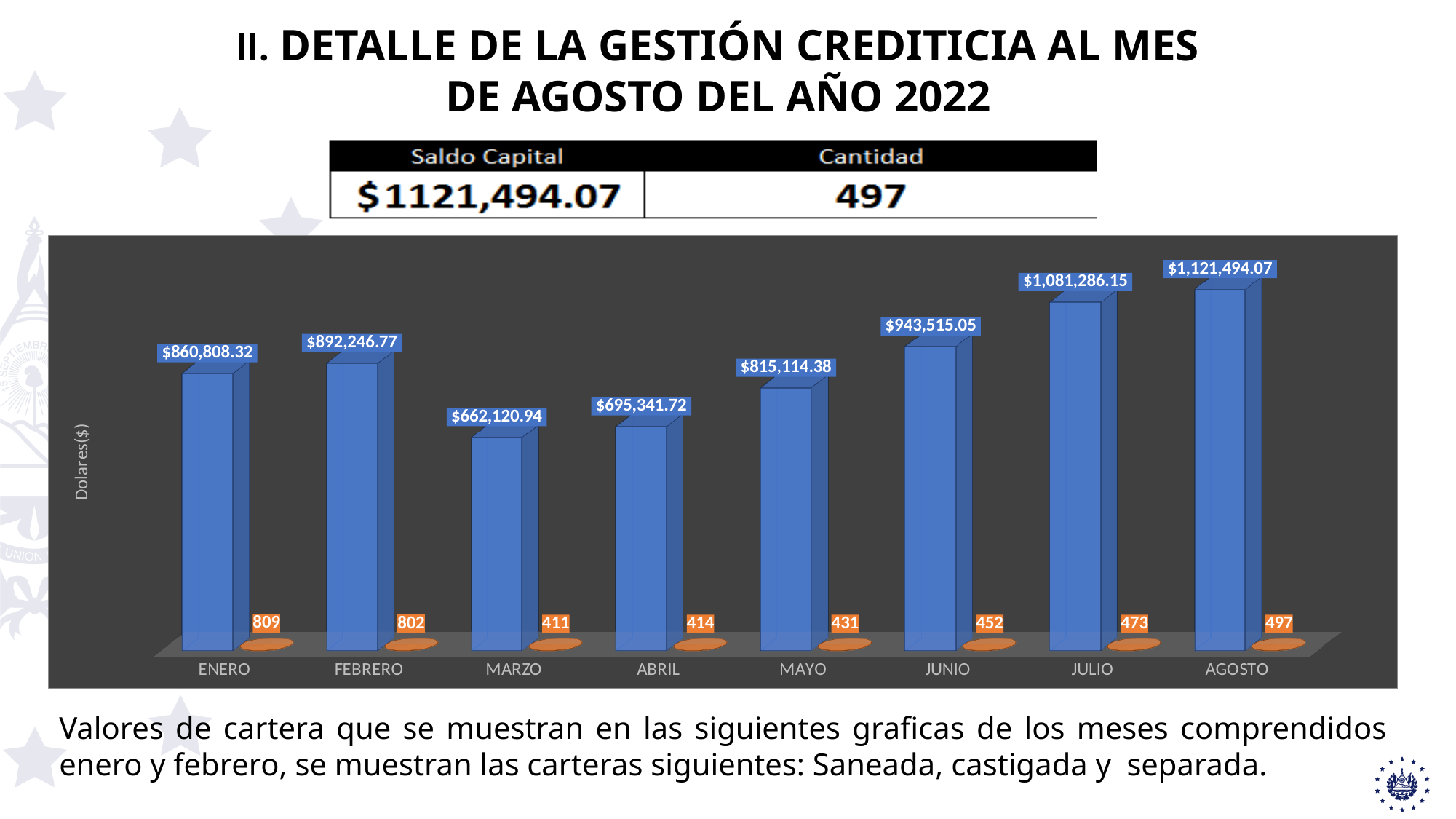
What is the dollar value shown for ENERO? $860,808.32 Do the dollar values rise or fall from MARZO to AGOSTO? rise What is the dollar value shown for JULIO? $1,081,286.15 What is the count (orange label) shown for JUNIO? 452 Which month has the lowest dollar value? MARZO Which has a larger dollar value, FEBRERO or MAYO? FEBRERO How many months are shown on the x axis? 8 What is the dollar value shown for MARZO? $662,120.94 Which month has the highest count (orange label)? ENERO What is the difference between the counts for ENERO and AGOSTO? 312 Which month has the highest dollar value? AGOSTO What is the difference between the dollar values for AGOSTO and JULIO? $40,207.92